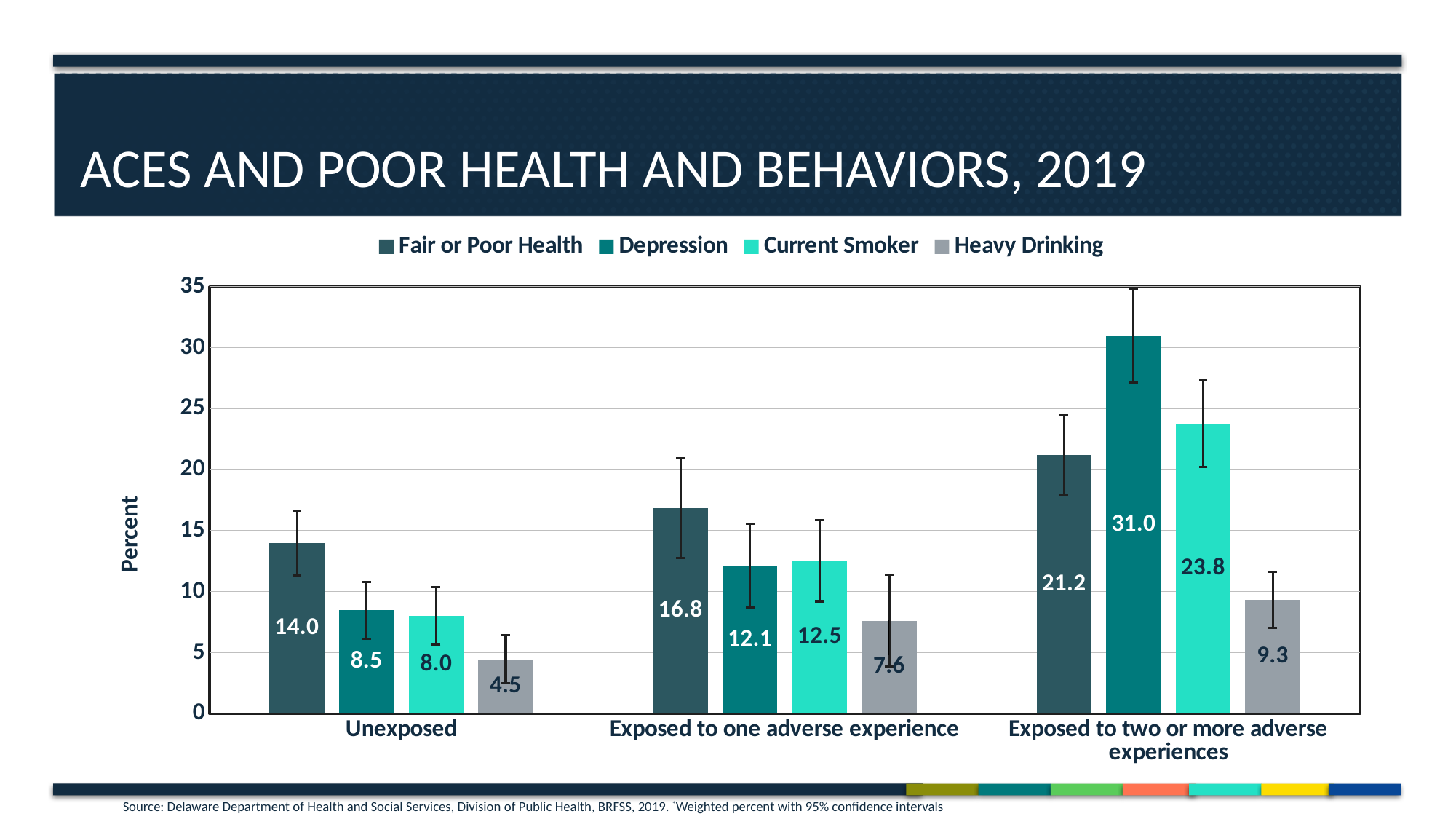
What is the value for Heavy Drinking in the Unexposed group? 4.5 Which is larger: Current Smoker in the Exposed to two or more adverse experiences group or Fair or Poor Health in the same group? Current Smoker Is the value for Depression in the Exposed to two or more adverse experiences group greater or less than 30? greater Do the Heavy Drinking values rise or fall as exposure increases from Unexposed to two or more adverse experiences? Rise What is the value for Depression in the Exposed to two or more adverse experiences group? 31.0 How many exposure categories are shown on the x axis? 3 What is the difference between the Fair or Poor Health values for the Exposed to two or more adverse experiences group and the Unexposed group? 7.2 What kind of chart is shown on the slide? Bar chart Which series has the highest value in the Exposed to two or more adverse experiences group? Depression How many series does the legend list? 4 Which series has the lowest value in the Unexposed group? Heavy Drinking What is the value for Current Smoker in the Exposed to one adverse experience group? 12.5